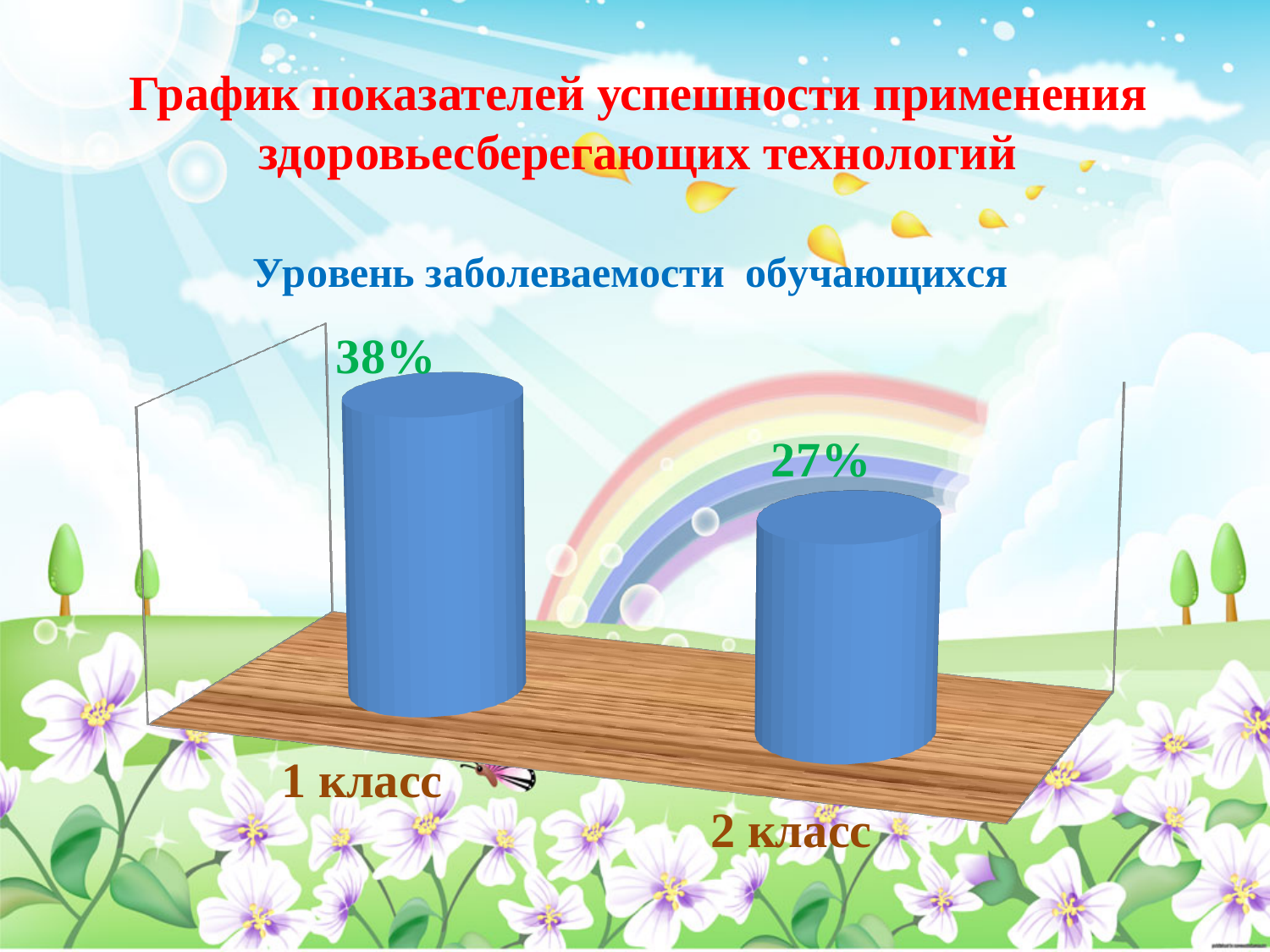
What is the value for 2 класс? 27% Which is larger, the value for 1 класс or the value for 2 класс? 1 класс What kind of chart is shown on the slide? bar chart What colour are the bars in the chart? blue Which category has the lowest value? 2 класс Do the values rise or fall from 1 класс to 2 класс? fall What is the subtitle of the chart? Уровень заболеваемости обучающихся What is the value for 1 класс? 38% What is the difference between the values for 1 класс and 2 класс? 11% Which category has the highest value? 1 класс How many categories are shown in the chart? 2